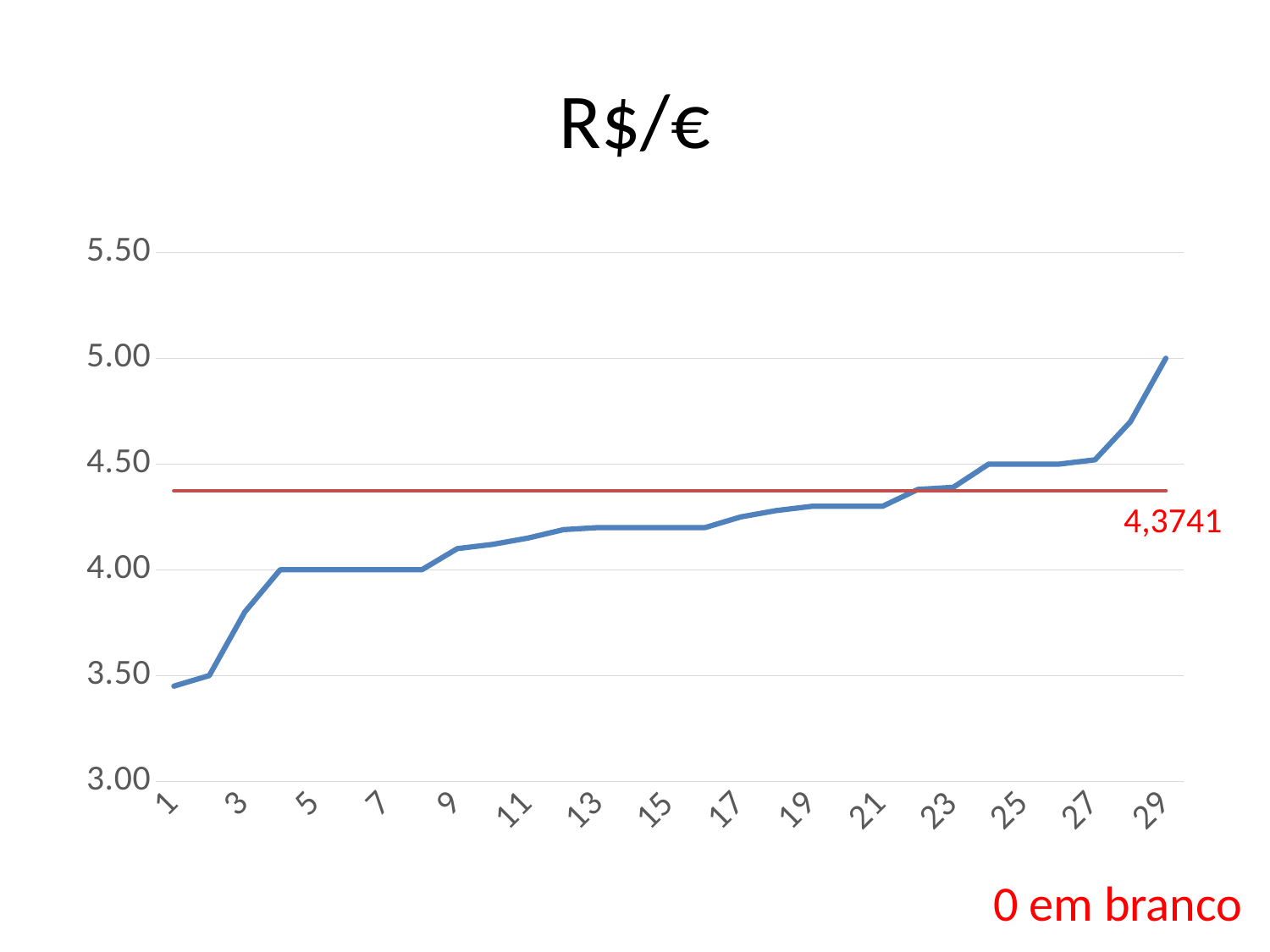
Do the values of the blue line generally rise or fall from point 1 to point 29? rise Is the value at point 21 greater or less than 4.50? less At which point does the blue line have its lowest value? 1 What is the value of the blue line at point 29? 5.00 Is the value at point 1 greater or less than 3.50? less What kind of chart is shown on the slide? line chart Is the value at point 13 greater or less than 4.00? greater Which has the larger value, point 3 or point 9? point 9 What value is labelled on the red horizontal line? 4,3741 What is the title of the chart? R$/€ At which point does the blue line reach its highest value? 29 What is the value of the blue line at point 5? 4.00